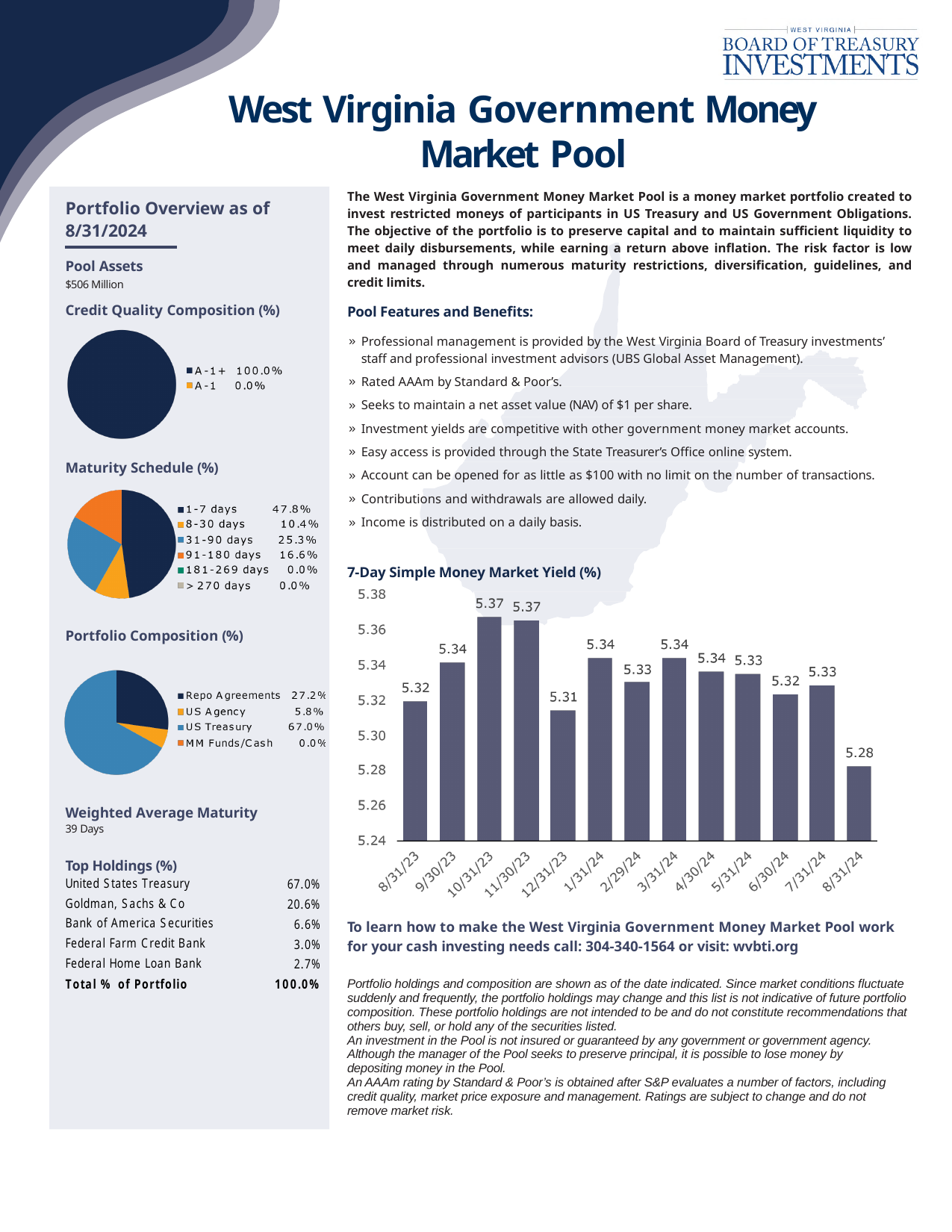
What kind of chart is the 7-Day Simple Money Market Yield chart? bar chart In the Maturity Schedule pie chart, what share is 1-7 days? 47.8% In the Portfolio Composition pie chart, what is the value for US Treasury? 67.0% In the 7-Day Simple Money Market Yield chart, what is the value for 12/31/23? 5.31 How many bars are plotted in the 7-Day Simple Money Market Yield chart? 13 In the 7-Day Simple Money Market Yield chart, is the value for 9/30/23 larger or smaller than the value for 12/31/23? larger In the Portfolio Composition pie chart, what is the difference between US Treasury and Repo Agreements? 39.8% In the 7-Day Simple Money Market Yield chart, which date has the lowest yield? 8/31/24 How many entries does the legend of the Maturity Schedule pie chart list? 6 In the 7-Day Simple Money Market Yield chart, what is the difference between the 10/31/23 value and the 8/31/24 value? 0.09 In the 7-Day Simple Money Market Yield chart, what is the value for 8/31/24? 5.28 In the Maturity Schedule pie chart, which category has the largest share? 1-7 days